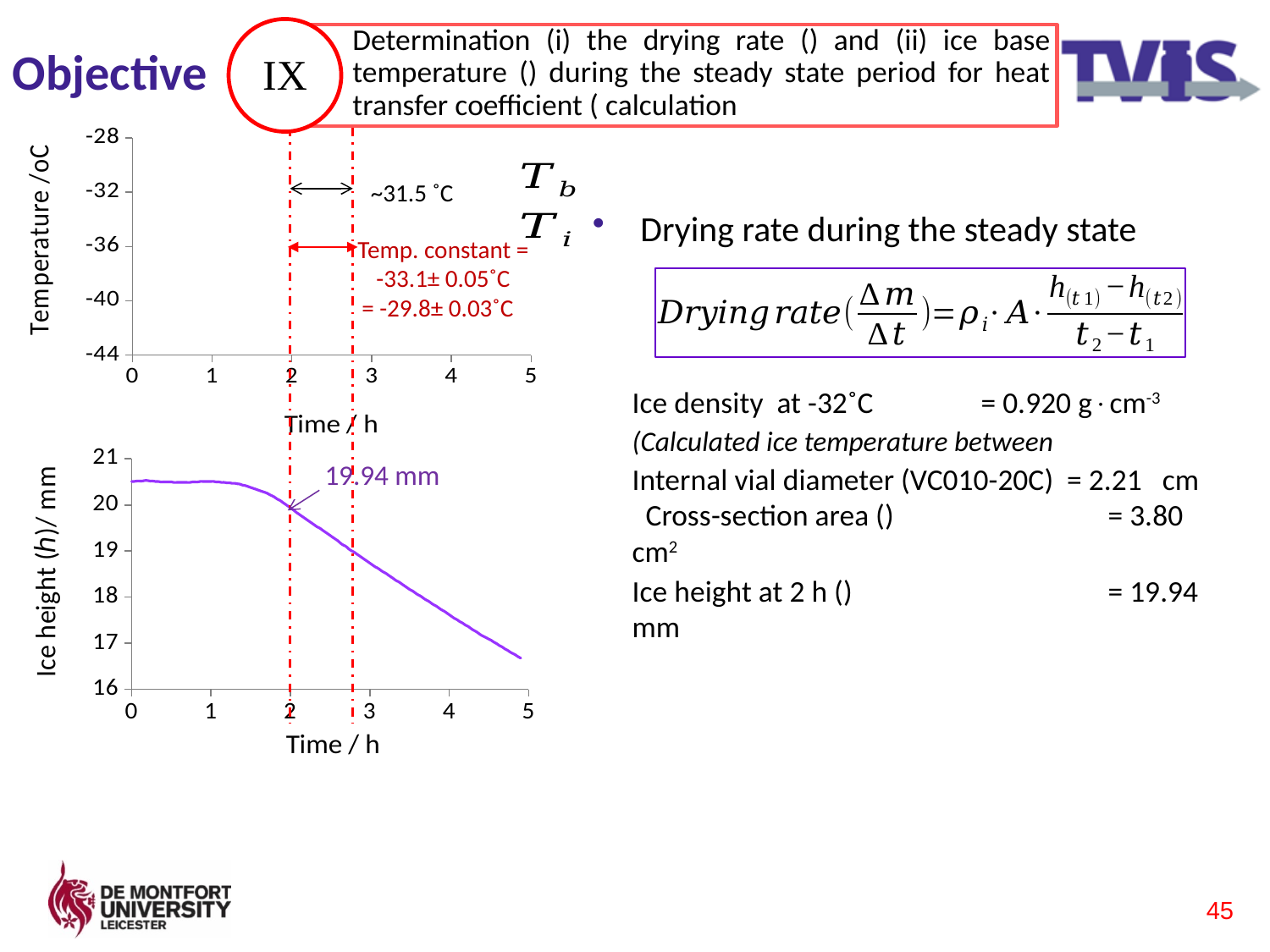
What is the y-axis label of the top chart? Temperature /oC How many data series are plotted in the bottom chart? 1 In the bottom chart, is the ice height at 1 h greater or less than 20 mm? greater What is the y-axis label of the bottom chart? Ice height (h)/ mm In the bottom chart, is the ice height at 4 h greater or less than 18 mm? less In the bottom chart, is the ice height at 0 h greater or less than 20 mm? greater In the bottom chart, what is the ice height at 2 h according to the data label? 19.94 mm In the bottom chart, what is the x-axis label? Time / h In the bottom chart, do the ice height values rise or fall as time increases? fall What kind of chart is the bottom chart (Ice height vs Time)? line chart In the bottom chart, is the ice height at 1 h larger or smaller than the ice height at 4 h? larger